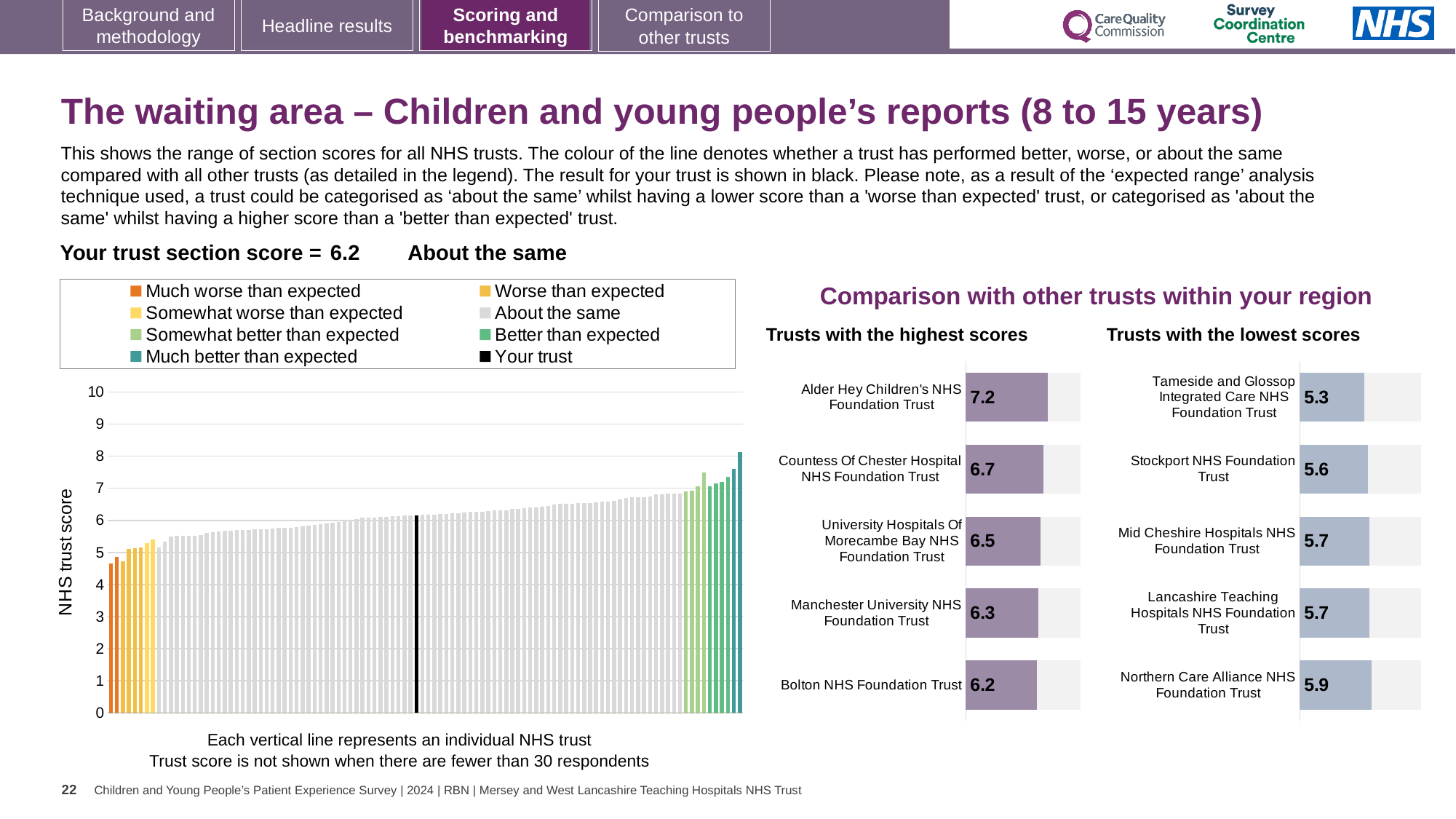
How many entries does the legend of the NHS trust score chart on the left list? 8 How many trusts are shown on the 'Trusts with the lowest scores' chart? 5 On the 'Trusts with the lowest scores' chart, what is the score for Stockport NHS Foundation Trust? 5.6 On the 'Trusts with the highest scores' chart, what is the difference between the scores of Alder Hey Children's NHS Foundation Trust and Bolton NHS Foundation Trust? 1.0 On the 'Trusts with the highest scores' chart, what is the score for Alder Hey Children's NHS Foundation Trust? 7.2 On the 'Trusts with the highest scores' chart, which trust has the lowest score? Bolton NHS Foundation Trust On the 'Trusts with the highest scores' chart, which has the larger score: Countess Of Chester Hospital NHS Foundation Trust or Manchester University NHS Foundation Trust? Countess Of Chester Hospital NHS Foundation Trust On the 'Trusts with the lowest scores' chart, which trust has the lowest score? Tameside and Glossop Integrated Care NHS Foundation Trust On the NHS trust score chart on the left, is the value of the leftmost (lowest) bar greater or less than 5? less On the NHS trust score chart on the left, what is the section score for your trust (the black bar)? 6.2 On the 'Trusts with the lowest scores' chart, what is the difference between the scores of Northern Care Alliance NHS Foundation Trust and Tameside and Glossop Integrated Care NHS Foundation Trust? 0.6 On the 'Trusts with the lowest scores' chart, which trust has the highest score? Northern Care Alliance NHS Foundation Trust